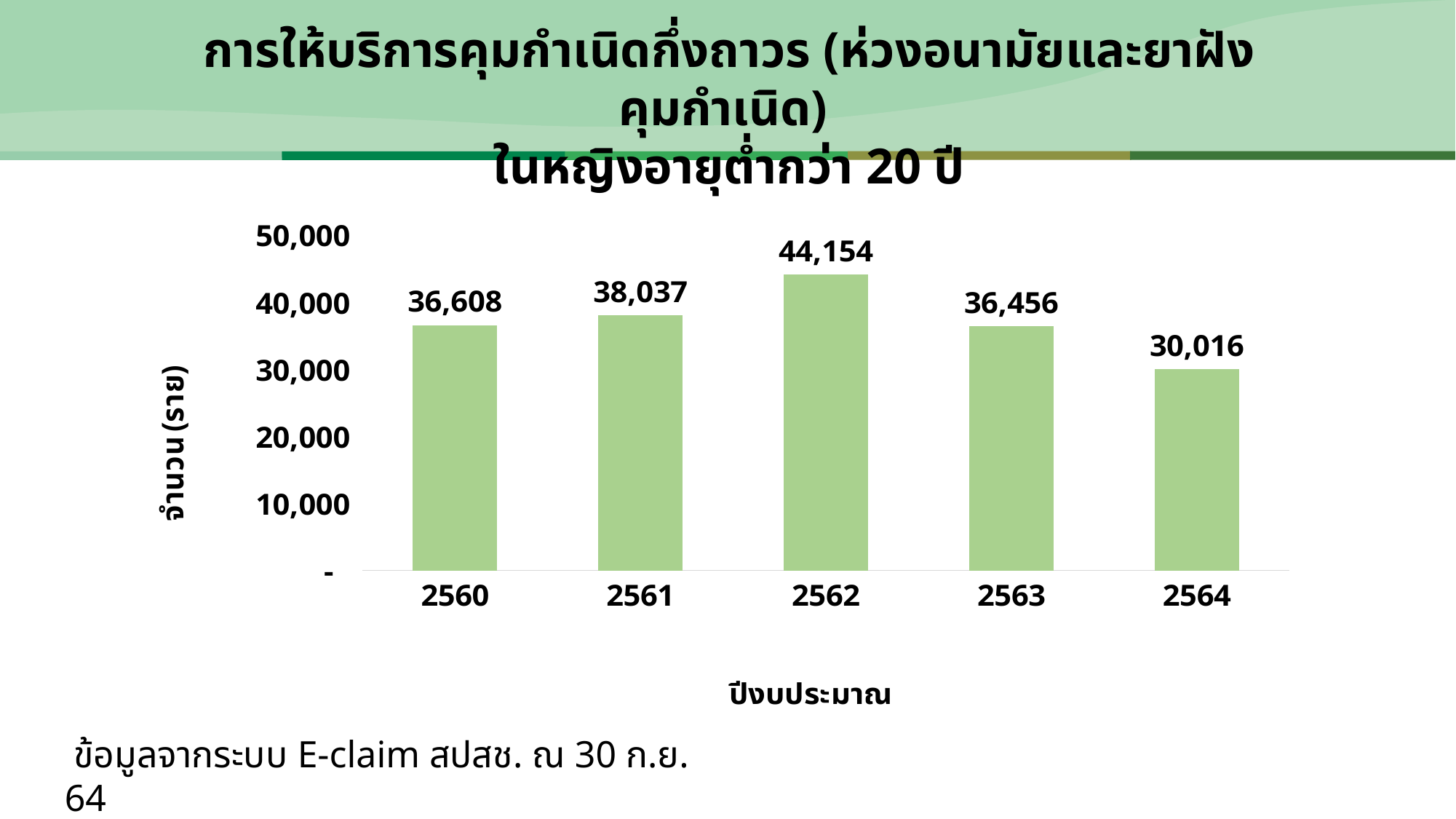
Which year has the lowest value? 2564 How many years are shown on the x axis? 5 Is the value for 2563 greater or less than 40,000? less What is the value for 2560? 36,608 Which year has the highest value? 2562 What is the difference between the values for 2562 and 2564? 14,138 What is the value for 2562? 44,154 Which is larger, the value for 2561 or the value for 2563? 2561 What is the value for 2564? 30,016 What kind of chart is shown on the slide? bar chart What is the difference between the values for 2561 and 2560? 1,429 What is the label of the x axis? ปีงบประมาณ